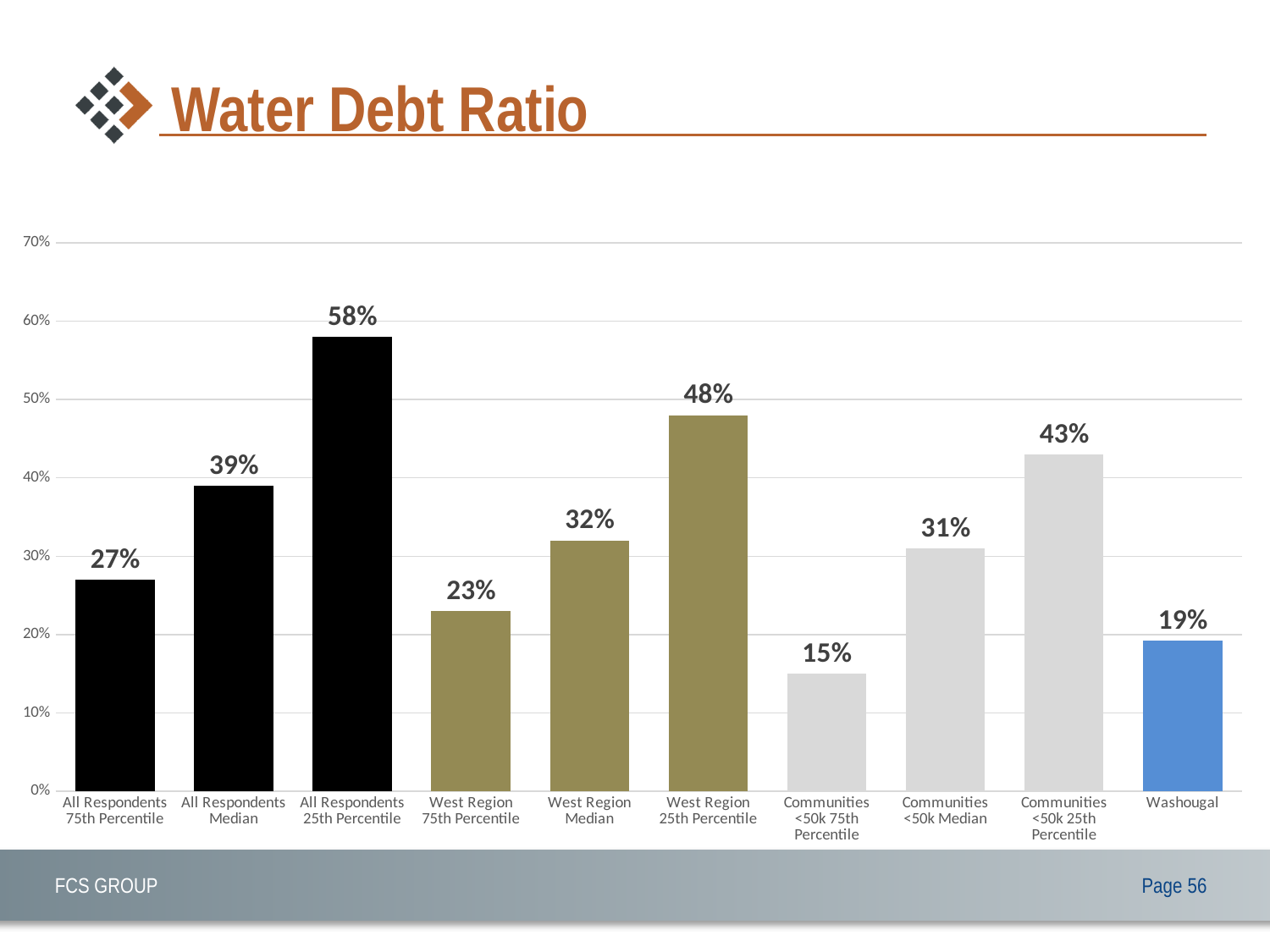
Which category has the highest value? All Respondents 25th Percentile What is the difference between All Respondents 25th Percentile and West Region 25th Percentile? 10% Which category has the lowest value? Communities <50k 75th Percentile What is the title of the slide? Water Debt Ratio What is the value for All Respondents Median? 39% Which is larger, West Region Median or Communities <50k Median? West Region Median How many categories are shown on the chart? 10 What kind of chart is shown on the slide? Bar chart What is the value for Communities <50k 75th Percentile? 15% What is the value for Washougal? 19% What is the value for West Region 25th Percentile? 48% Is the value for Communities <50k 25th Percentile greater or less than 40%? greater